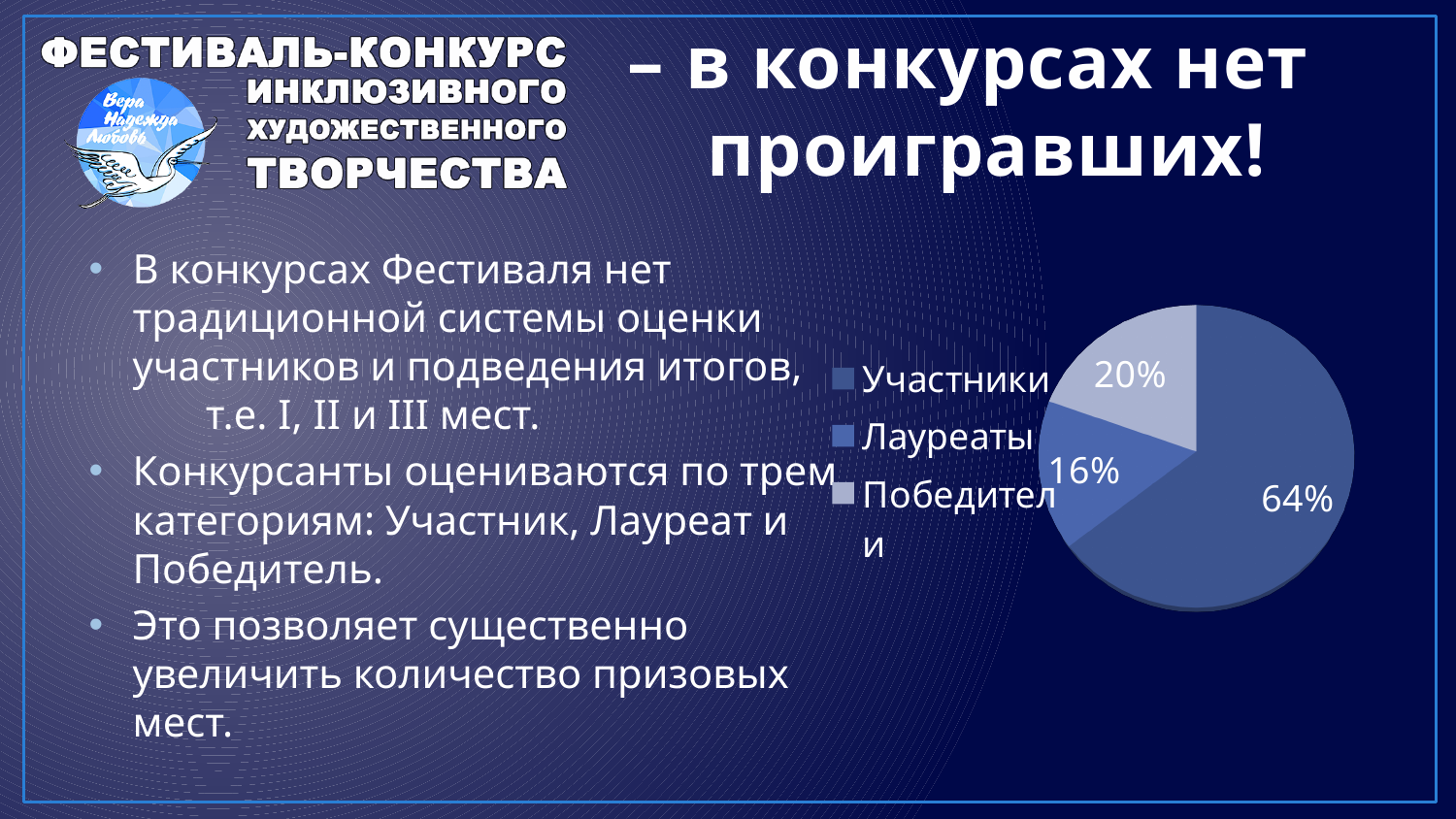
What kind of chart is shown on the slide? pie chart What share of the pie does Победители have? 20% What is the difference in percentage points between Участники and Победители? 44 Which category has the smallest slice of the pie? Лауреаты What is the difference in percentage points between Победители and Лауреаты? 4 Which legend entry is listed first in the pie chart's legend? Участники What share of the pie does Лауреаты have? 16% Which is larger, the share for Победители or the share for Лауреаты? Победители Which category has the largest slice of the pie? Участники How many entries does the legend list? 3 How many slices does the pie chart have? 3 What share of the pie does Участники have? 64%